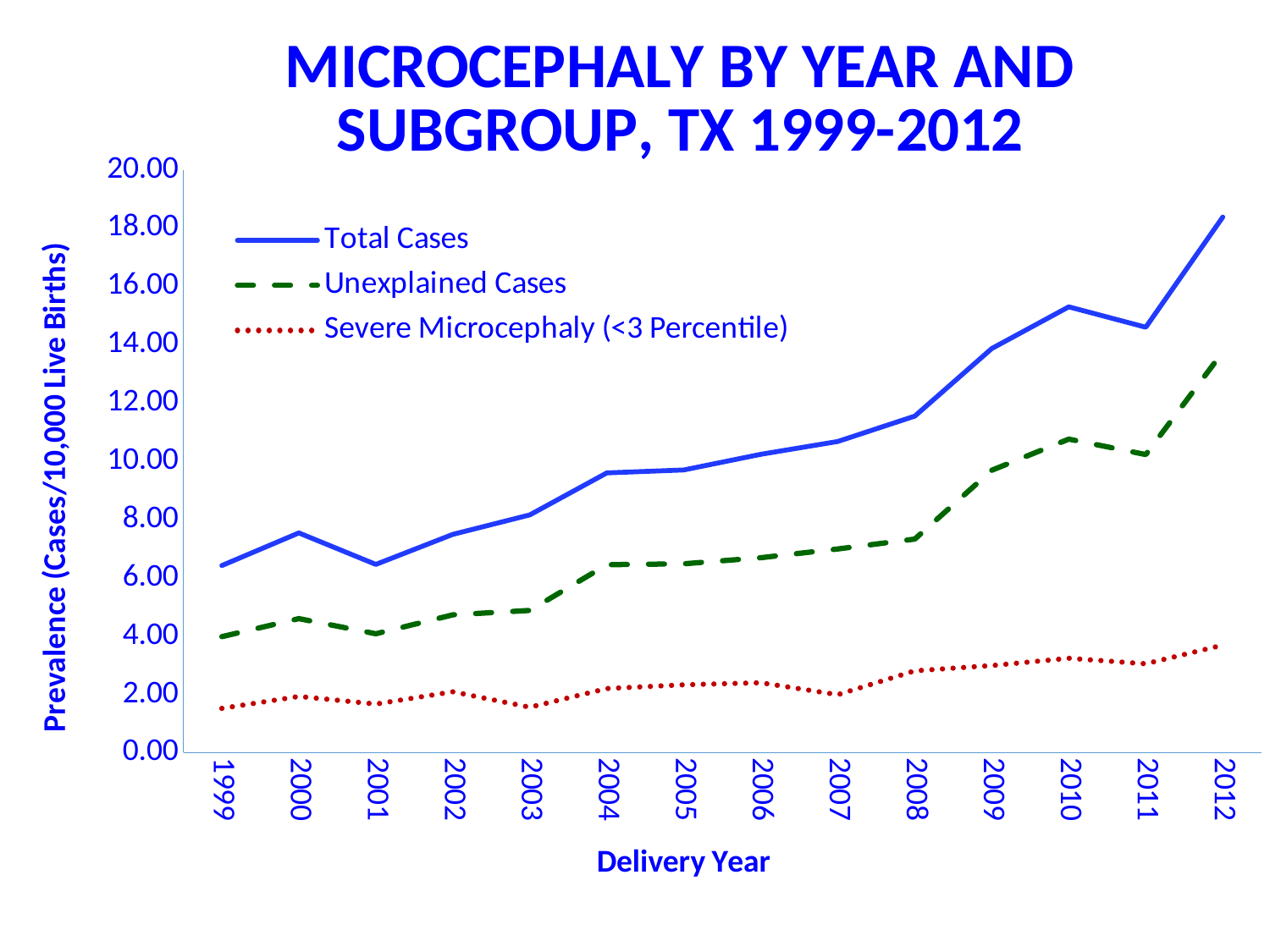
Overall, do the Total Cases values rise or fall from 1999 to 2012? Rise In 2012, which series has the higher value, Total Cases or Severe Microcephaly (<3 Percentile)? Total Cases Is the Total Cases value for 1999 greater or less than 8.00? less Is the Total Cases value for 2012 greater or less than 16.00? greater What is the label of the y axis? Prevalence (Cases/10,000 Live Births) How many delivery years are plotted along the x axis? 14 In which year is the Total Cases prevalence highest? 2012 What kind of chart is shown on the slide? Line chart Is the Severe Microcephaly (<3 Percentile) value for 1999 greater or less than 2.00? less How many series does the legend list? 3 Which is larger, the Total Cases value for 2010 or for 2011? 2010